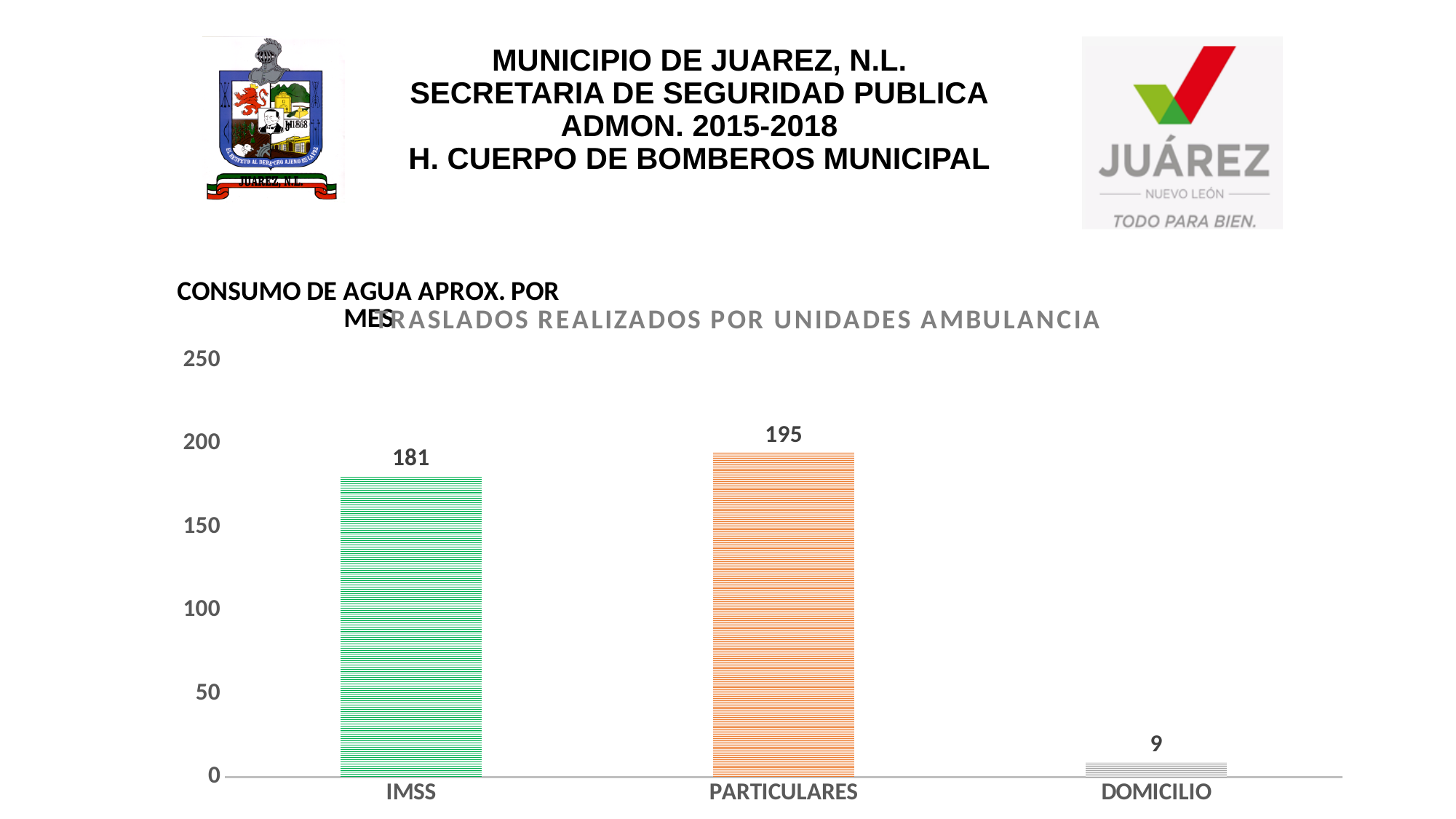
What is the value for PARTICULARES in the chart? 195 What is the value for IMSS in the chart? 181 How many categories are shown in the chart? 3 What is the difference between the values for IMSS and DOMICILIO? 172 What is the difference between the values for PARTICULARES and IMSS? 14 Which is larger, the value for IMSS or the value for PARTICULARES? PARTICULARES Which category has the highest value? PARTICULARES What is the title of the chart? TRASLADOS REALIZADOS POR UNIDADES AMBULANCIA Which category has the lowest value? DOMICILIO What kind of chart is shown on the slide? bar chart What is the value for DOMICILIO in the chart? 9 Is the value for IMSS greater or less than 150? greater